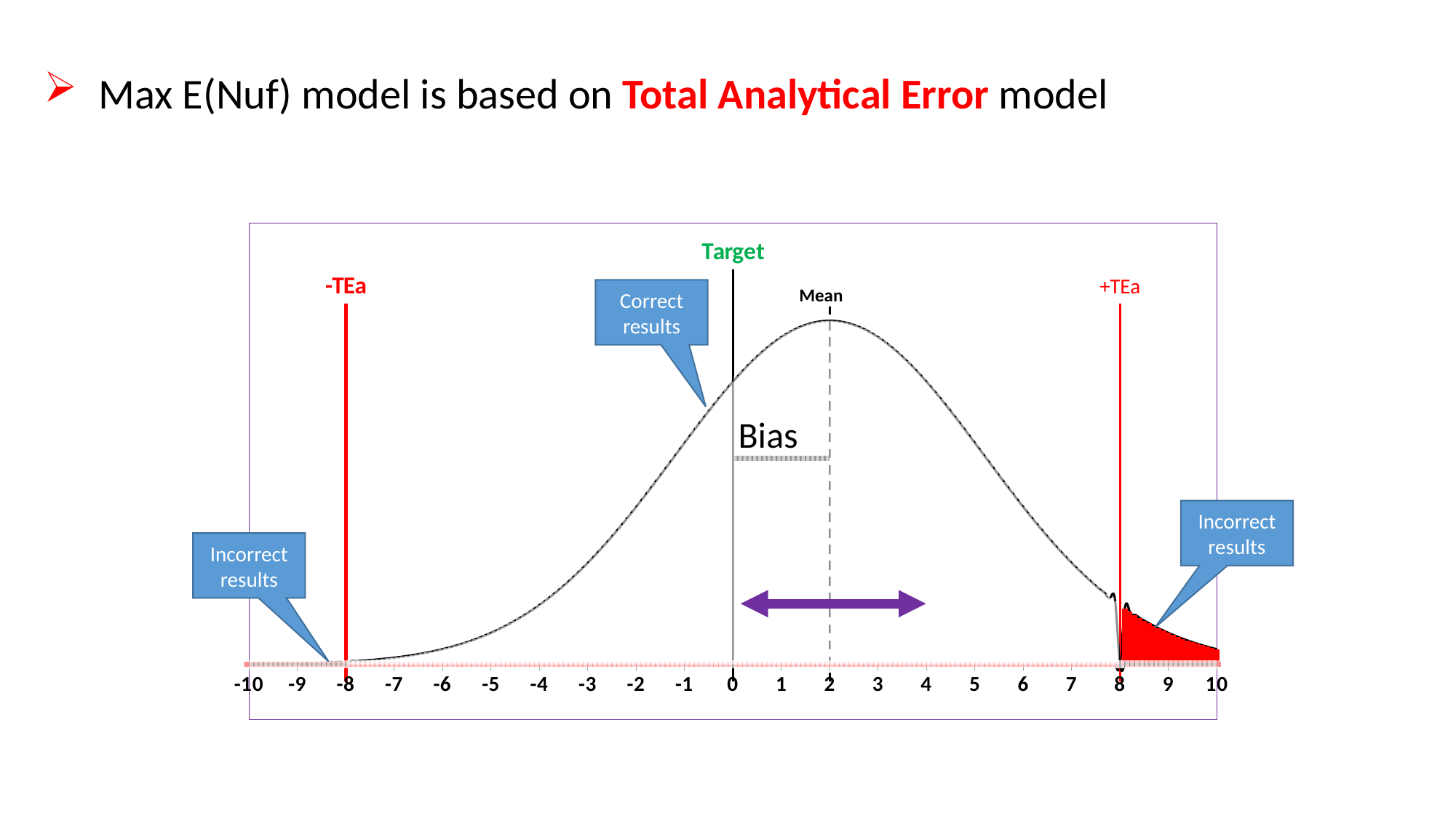
At what x-axis value is the +TEa limit drawn? 8 At what x-axis value is the Target line drawn? 0 How many tick labels are shown on the x axis? 21 At which x-axis value does the curve reach its highest point? 2 Does the curve rise or fall as x goes from -10 to 2? rise At what x-axis value is the Mean marked on the chart? 2 Does the curve rise or fall as x goes from 2 to 10? fall What is the lowest value shown on the x axis? -10 What label is given to the horizontal distance between the Target line and the Mean line? Bias At what x-axis value is the -TEa limit drawn? -8 Is the curve higher at x = 0 or at x = 2? 2